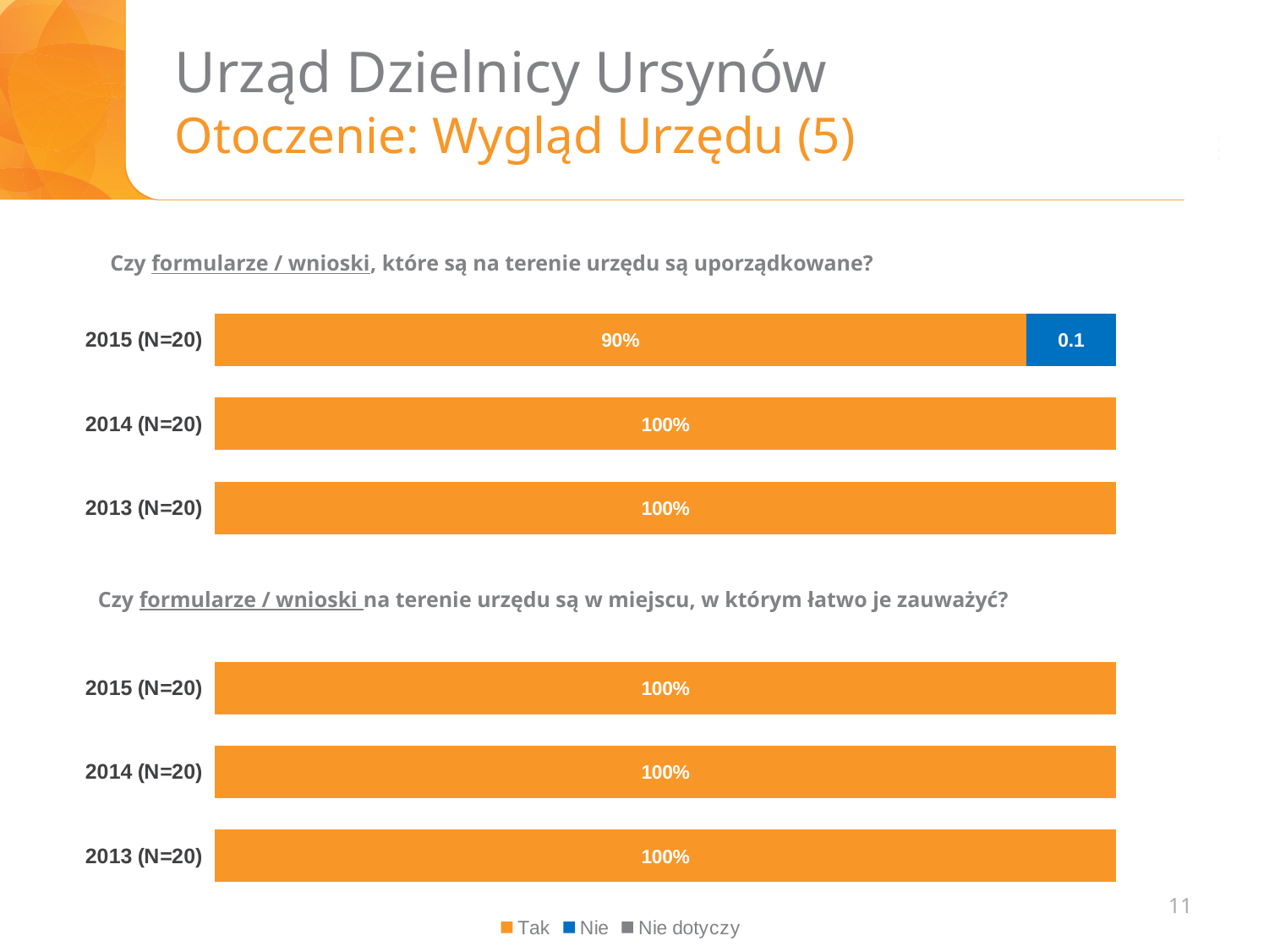
In the top chart ("Czy formularze / wnioski, które są na terenie urzędu są uporządkowane?"), what is the "Tak" value for 2014 (N=20)? 100% What type of chart is the top chart ("Czy formularze / wnioski, które są na terenie urzędu są uporządkowane?")? Bar chart In the top chart ("Czy formularze / wnioski, które są na terenie urzędu są uporządkowane?"), is the "Tak" value for 2013 (N=20) or for 2015 (N=20) larger? 2013 (N=20) In the top chart ("Czy formularze / wnioski, które są na terenie urzędu są uporządkowane?"), what is the value of the "Tak" bar for 2015 (N=20)? 90% How many series does the legend at the bottom of the slide list? 3 In the bottom chart ("Czy formularze / wnioski na terenie urzędu są w miejscu, w którym łatwo je zauważyć?"), what is the "Tak" value for 2013 (N=20)? 100% In the top chart ("Czy formularze / wnioski, które są na terenie urzędu są uporządkowane?"), which year has the lowest "Tak" value? 2015 (N=20) In the top chart ("Czy formularze / wnioski, które są na terenie urzędu są uporządkowane?"), what is the difference between the "Tak" value for 2014 (N=20) and for 2015 (N=20)? 10% In the top chart ("Czy formularze / wnioski, które są na terenie urzędu są uporządkowane?"), what label is printed on the blue "Nie" segment for 2015 (N=20)? 0.1 Which legend entry is shown in orange? Tak In the bottom chart ("Czy formularze / wnioski na terenie urzędu są w miejscu, w którym łatwo je zauważyć?"), what is the "Tak" value for 2015 (N=20)? 100% How many year categories does the bottom chart ("Czy formularze / wnioski na terenie urzędu są w miejscu, w którym łatwo je zauważyć?") show? 3